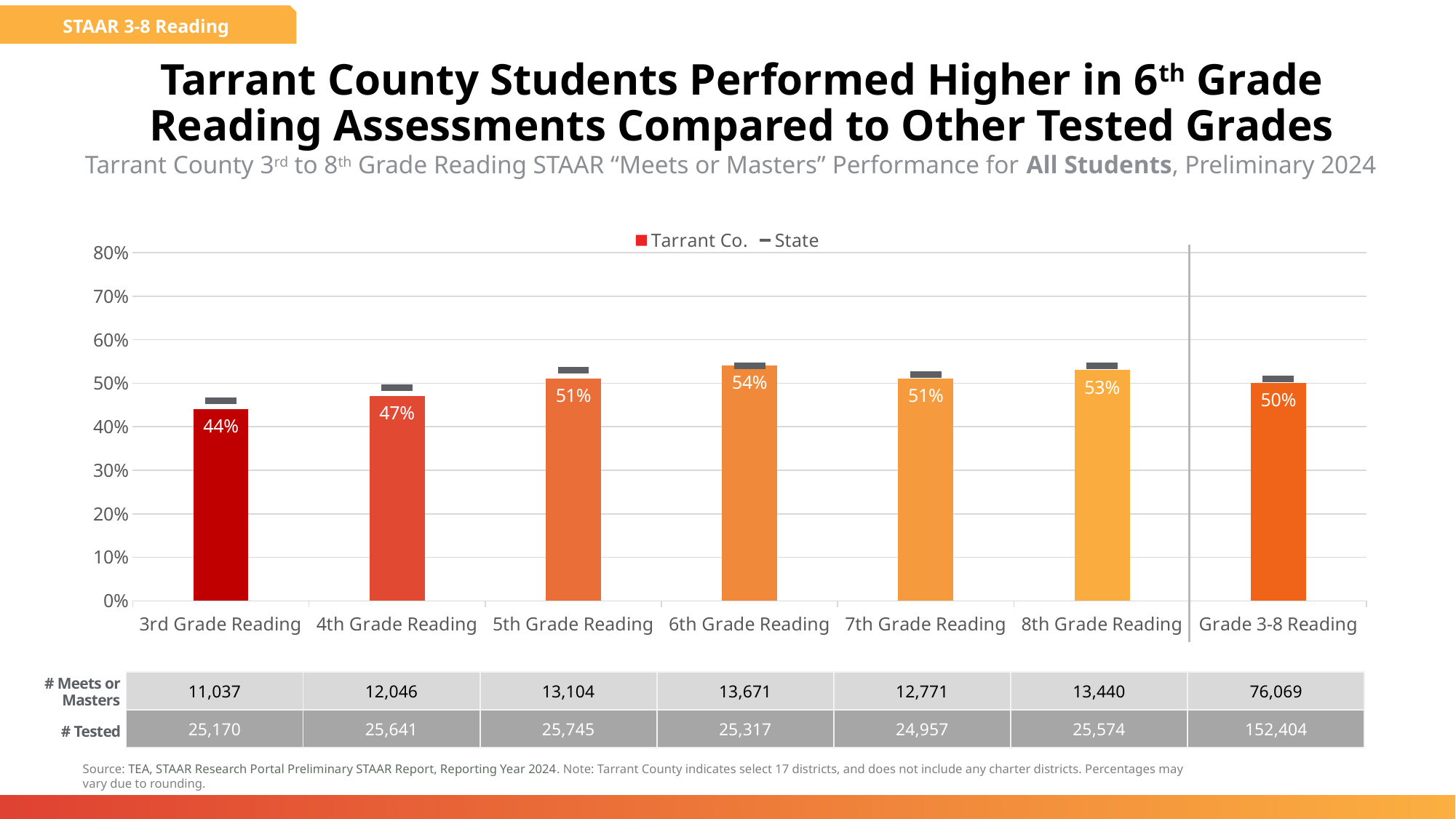
What kind of chart is shown on the slide? Bar chart What are the two series named in the chart legend? Tarrant Co. and State Which has a higher Tarrant Co. value, 4th Grade Reading or 5th Grade Reading? 5th Grade Reading What is the difference in percentage points between the Tarrant Co. values for 6th Grade Reading and 3rd Grade Reading? 10 percentage points Which grade has the lowest Tarrant Co. Meets or Masters percentage? 3rd Grade Reading How many categories are shown on the x axis of the chart? 7 What is the Tarrant Co. value for 3rd Grade Reading? 44% What percentage of Tarrant County 6th Grade Reading students scored Meets or Masters? 54% Do the Tarrant Co. values rise or fall from 3rd Grade Reading to 6th Grade Reading? Rise Which grade has the highest Tarrant Co. Meets or Masters percentage? 6th Grade Reading Is the State marker for 3rd Grade Reading greater or less than 40%? greater How many series does the legend list? 2